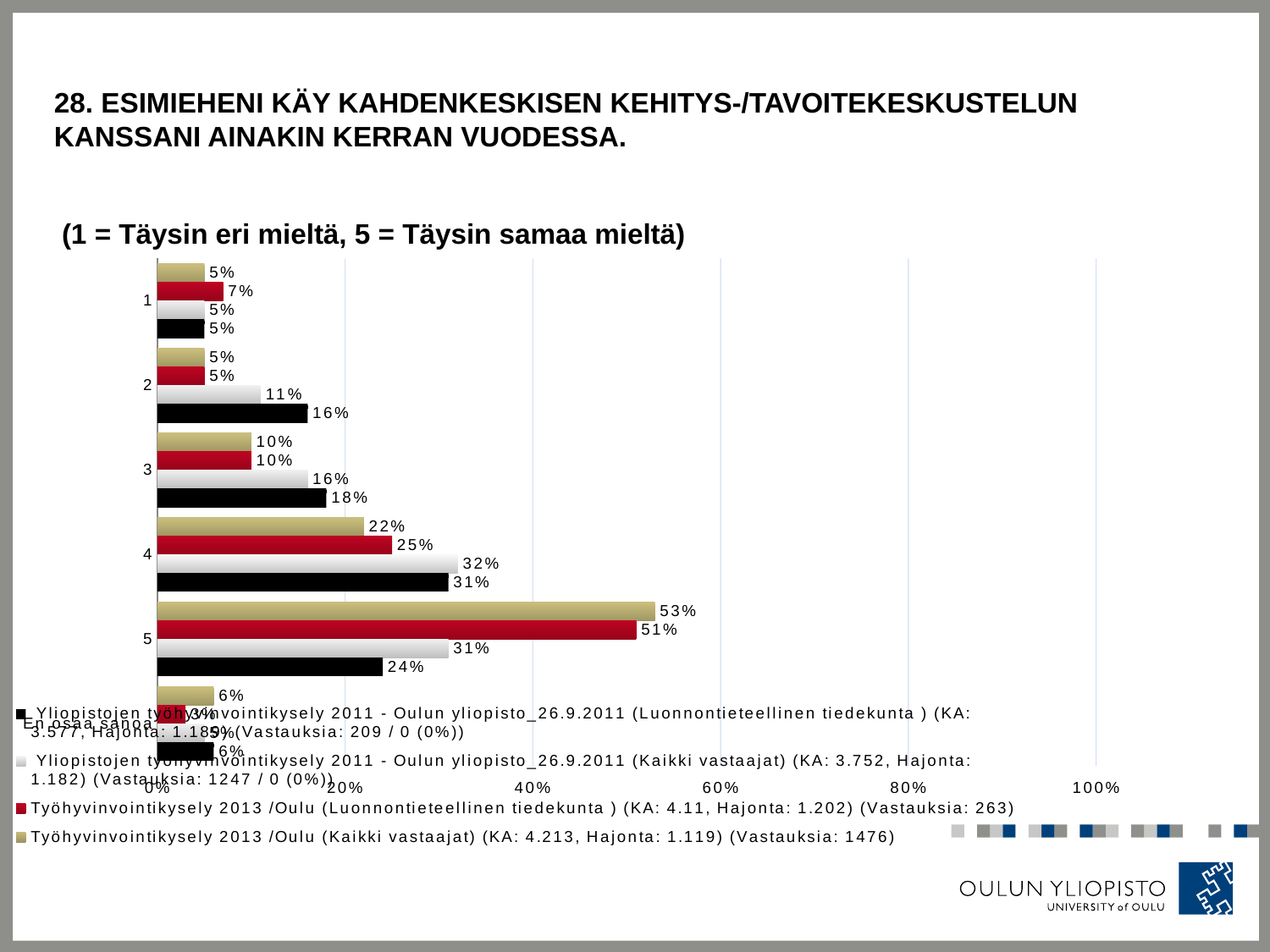
Is the value for category 5 in the Työhyvinvointikysely 2013 /Oulu (Kaikki vastaajat) series greater or less than 40%? greater What is the difference between the category 5 values of the Työhyvinvointikysely 2013 /Oulu (Kaikki vastaajat) series and the Yliopistojen työhyvinvointikysely 2011 (Luonnontieteellinen tiedekunta) series? 29% How many series does the legend list? 4 For category 4, which is larger: the Työhyvinvointikysely 2013 /Oulu (Luonnontieteellinen tiedekunta) value or the Työhyvinvointikysely 2013 /Oulu (Kaikki vastaajat) value? Työhyvinvointikysely 2013 /Oulu (Luonnontieteellinen tiedekunta) What is the value for category 5 in the series Työhyvinvointikysely 2013 /Oulu (Kaikki vastaajat)? 53% What is the value for category 4 in the series Yliopistojen työhyvinvointikysely 2011 - Oulun yliopisto (Kaikki vastaajat)? 32% What type of chart is shown on the slide? bar chart Which category has the highest value in the series Työhyvinvointikysely 2013 /Oulu (Kaikki vastaajat)? 5 What is the value for category 2 in the series Yliopistojen työhyvinvointikysely 2011 - Oulun yliopisto (Luonnontieteellinen tiedekunta)? 16% What is the value for category 5 in the series Työhyvinvointikysely 2013 /Oulu (Luonnontieteellinen tiedekunta)? 51% What is the value for 'En osaa sanoa' in the series Työhyvinvointikysely 2013 /Oulu (Luonnontieteellinen tiedekunta)? 3% What is the value for category 3 in the series Yliopistojen työhyvinvointikysely 2011 - Oulun yliopisto (Luonnontieteellinen tiedekunta)? 18%